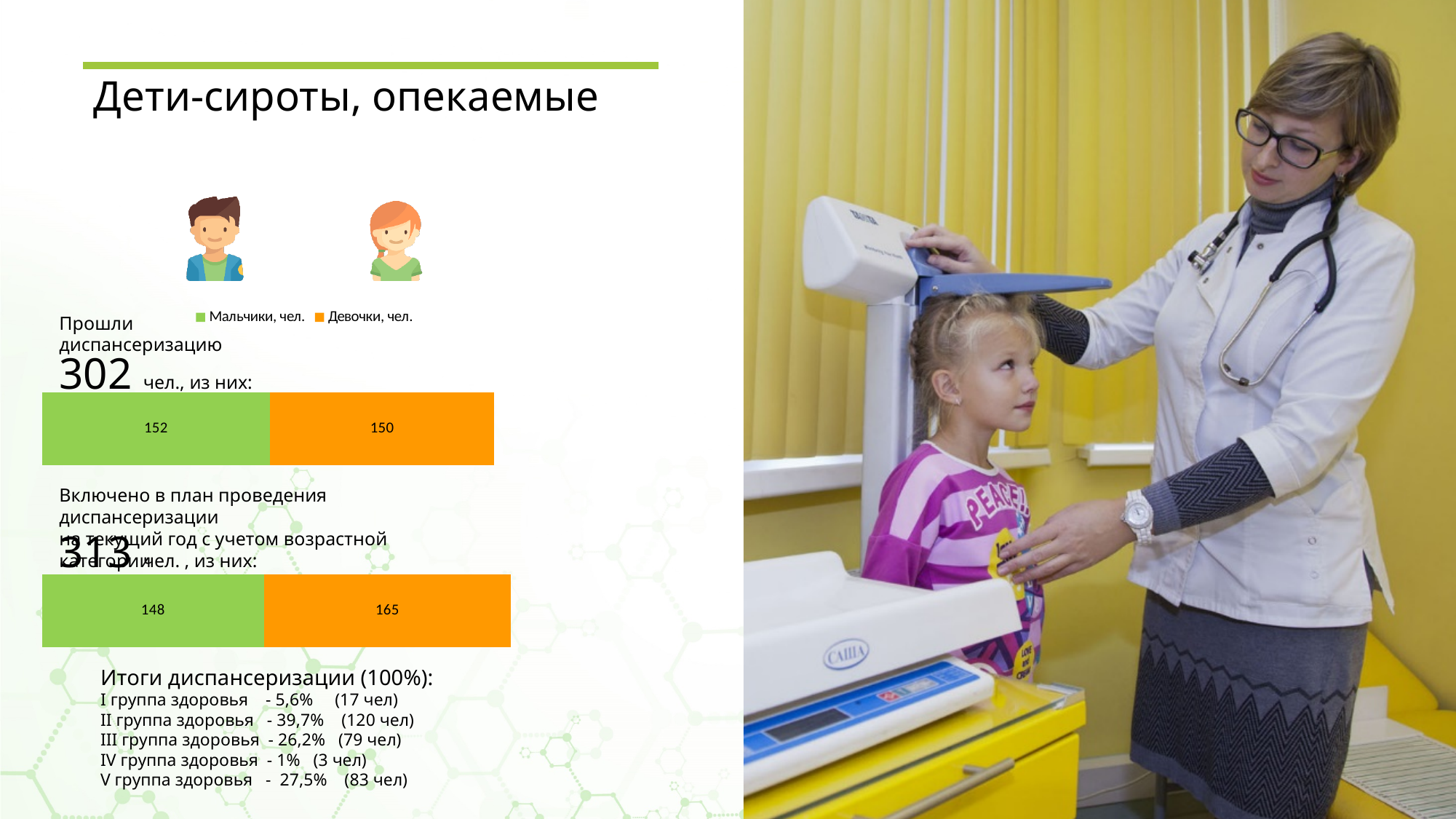
In the lower bar chart (Включено в план проведения диспансеризации), what is the value for Девочки, чел.? 165 What is the total of the stacked bar in the upper chart? 302 What is the total of the stacked bar in the lower chart? 313 In the lower bar chart, what is the difference between the Девочки and Мальчики values? 17 In the upper bar chart (Прошли диспансеризацию), what is the value for Девочки, чел.? 150 In the upper bar chart (Прошли диспансеризацию), what is the value for Мальчики, чел.? 152 Which colour represents Девочки, чел. in the legend? Orange What kind of chart is used to show the Мальчики and Девочки values? Stacked bar chart In the upper bar chart, what is the difference between the Мальчики and Девочки values? 2 In the lower bar chart, which series has the larger value, Мальчики or Девочки? Девочки In the lower bar chart (Включено в план проведения диспансеризации), what is the value for Мальчики, чел.? 148 How many series does the legend list for the bar charts? 2